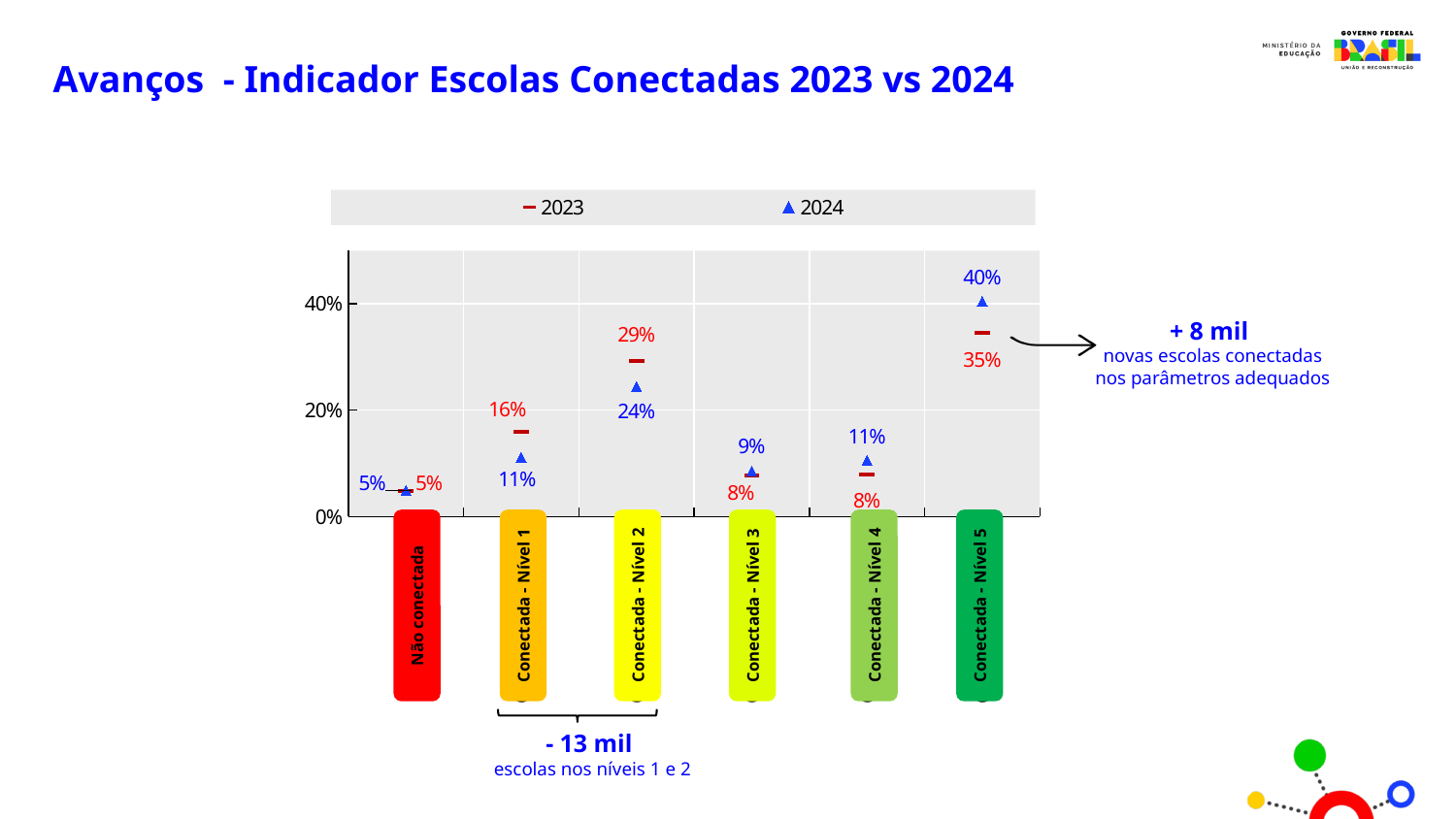
What is the difference between the 2024 and 2023 values for Conectada - Nível 5? 5% What is the 2023 value for Conectada - Nível 4? 8% What is the 2024 value for Conectada - Nível 5? 40% Which category has the lowest 2023 value? Não conectada Which marker symbol represents the 2024 series in the legend? A blue triangle What is the difference between the 2023 and 2024 values for Conectada - Nível 2? 5% What is the 2024 value for Conectada - Nível 1? 11% How many categories are shown on the x axis? 6 For Conectada - Nível 1, which year has the larger value, 2023 or 2024? 2023 How many series does the legend list? 2 Which category has the highest 2024 value? Conectada - Nível 5 What is the 2023 value for Conectada - Nível 2? 29%